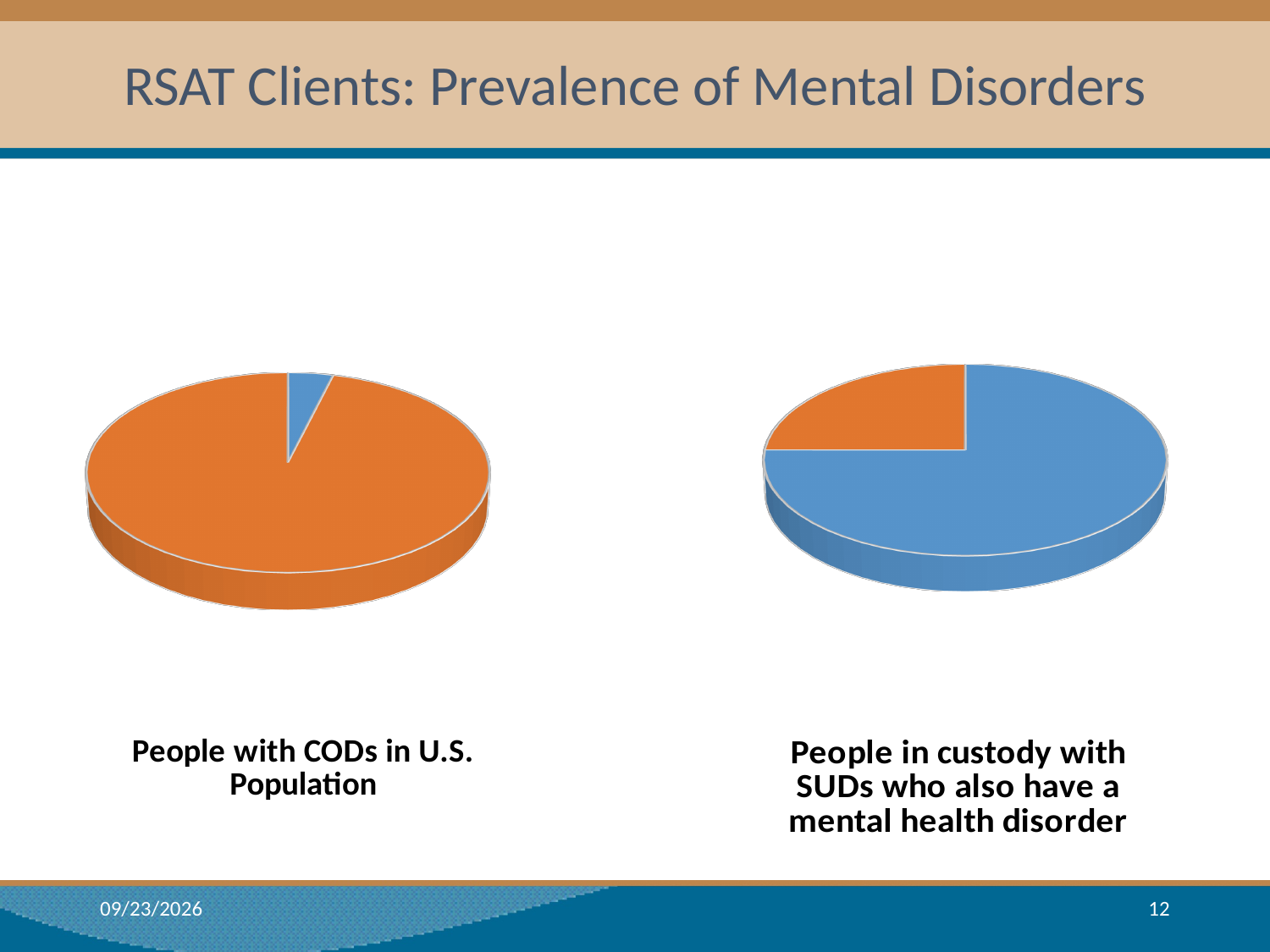
In the pie chart titled "People with CODs in U.S. Population", which slice is larger, the orange slice or the blue slice? the orange slice In the pie chart titled "People in custody with SUDs who also have a mental health disorder", which colour is the smallest slice? orange In the pie chart titled "People with CODs in U.S. Population", which colour is the smallest slice? blue How many slices does the pie chart titled "People in custody with SUDs who also have a mental health disorder" have? 2 In the pie chart titled "People in custody with SUDs who also have a mental health disorder", which slice is larger, the blue slice or the orange slice? the blue slice How many slices does the pie chart titled "People with CODs in U.S. Population" have? 2 What is the title of the pie chart on the right side of the slide? People in custody with SUDs who also have a mental health disorder What kind of chart is the chart titled "People in custody with SUDs who also have a mental health disorder"? pie chart What kind of chart is the chart titled "People with CODs in U.S. Population"? pie chart What is the title of the pie chart on the left side of the slide? People with CODs in U.S. Population How many pie charts are shown on the slide? 2